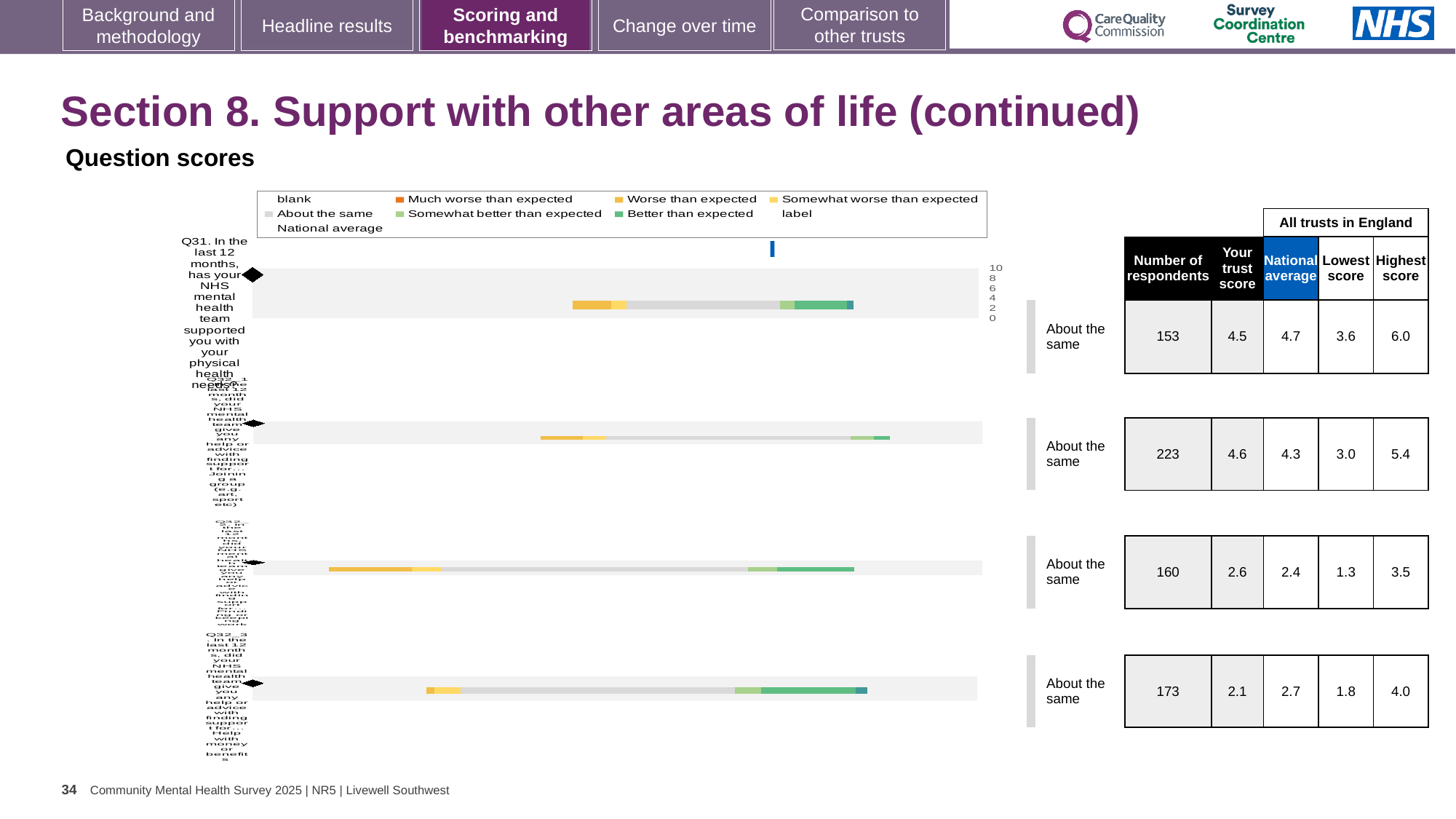
How many entries does the chart legend list? 9 How many question bars are plotted in the chart? 4 What is the trust's score for Q31 (the top row of the table)? 4.5 Which row of the table has the largest number of respondents? the second row (223) For Q31 (the top row), which is larger: the trust's score or the national average? national average What is the highest score among all trusts in England for Q31 (the top row of the table)? 6.0 What is the difference between the highest score and the lowest score for Q31 (the top row of the table)? 2.4 What kind of chart is used to show the question scores on this slide? bar chart What is the trust's score in the bottom row of the table? 2.1 What is the number of respondents for Q31 (the top row of the table)? 153 What benchmark category is shown for every question on this slide? About the same What is the national average for Q31 (the top row of the table)? 4.7